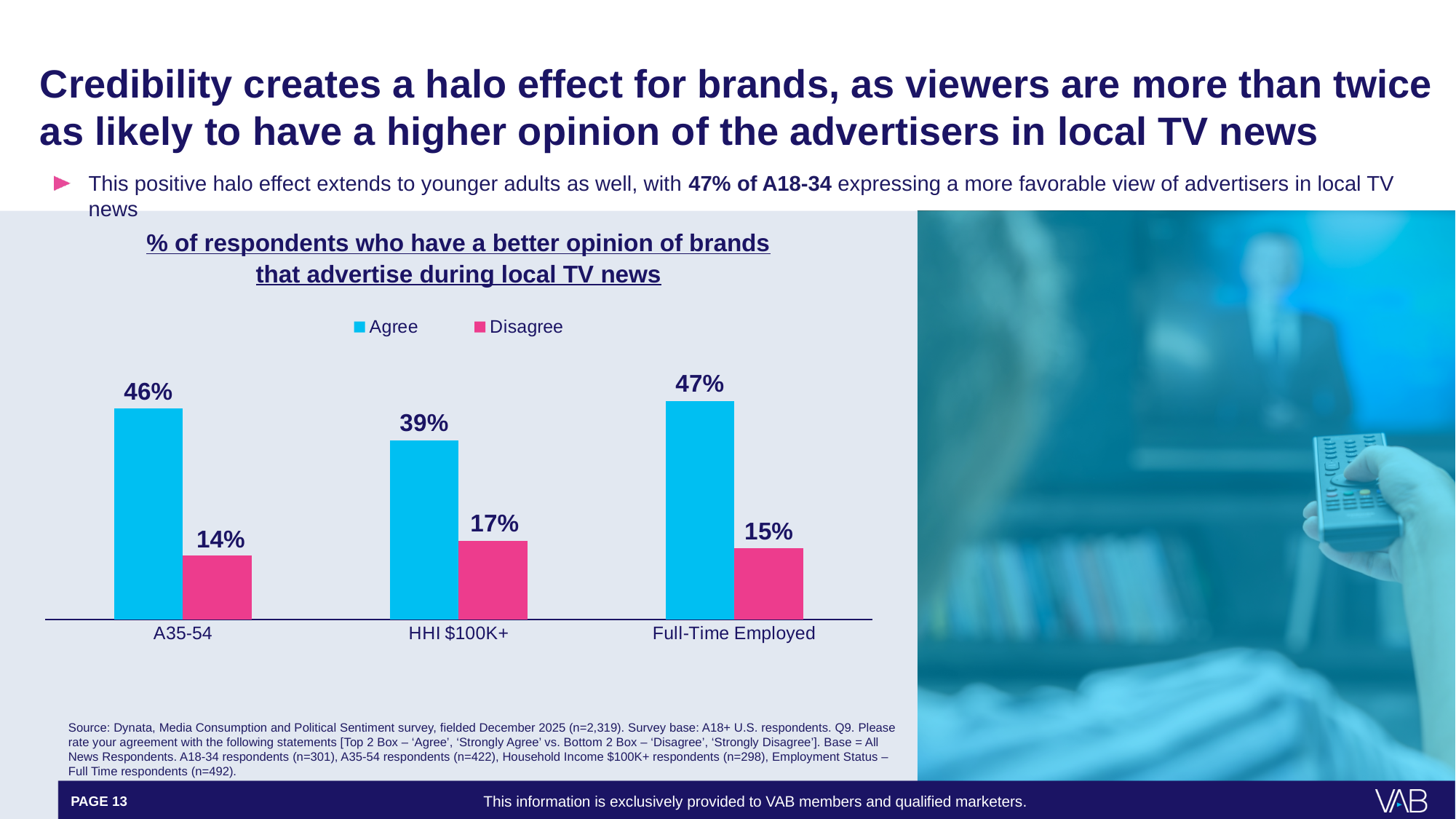
What is the Disagree value for A35-54? 14% What is the Agree value for A35-54? 46% What is the difference between the Agree and Disagree values for A35-54? 32 percentage points Which category has the lowest Agree value? HHI $100K+ Which is larger for Full-Time Employed, the Agree value or the Disagree value? Agree What kind of chart is shown on the slide? Bar chart How many series does the legend list? 2 How many categories are shown on the x axis? 3 What is the Agree value for Full-Time Employed? 47% What is the Disagree value for HHI $100K+? 17% Which category has the highest Agree value? Full-Time Employed Which category has the highest Disagree value? HHI $100K+